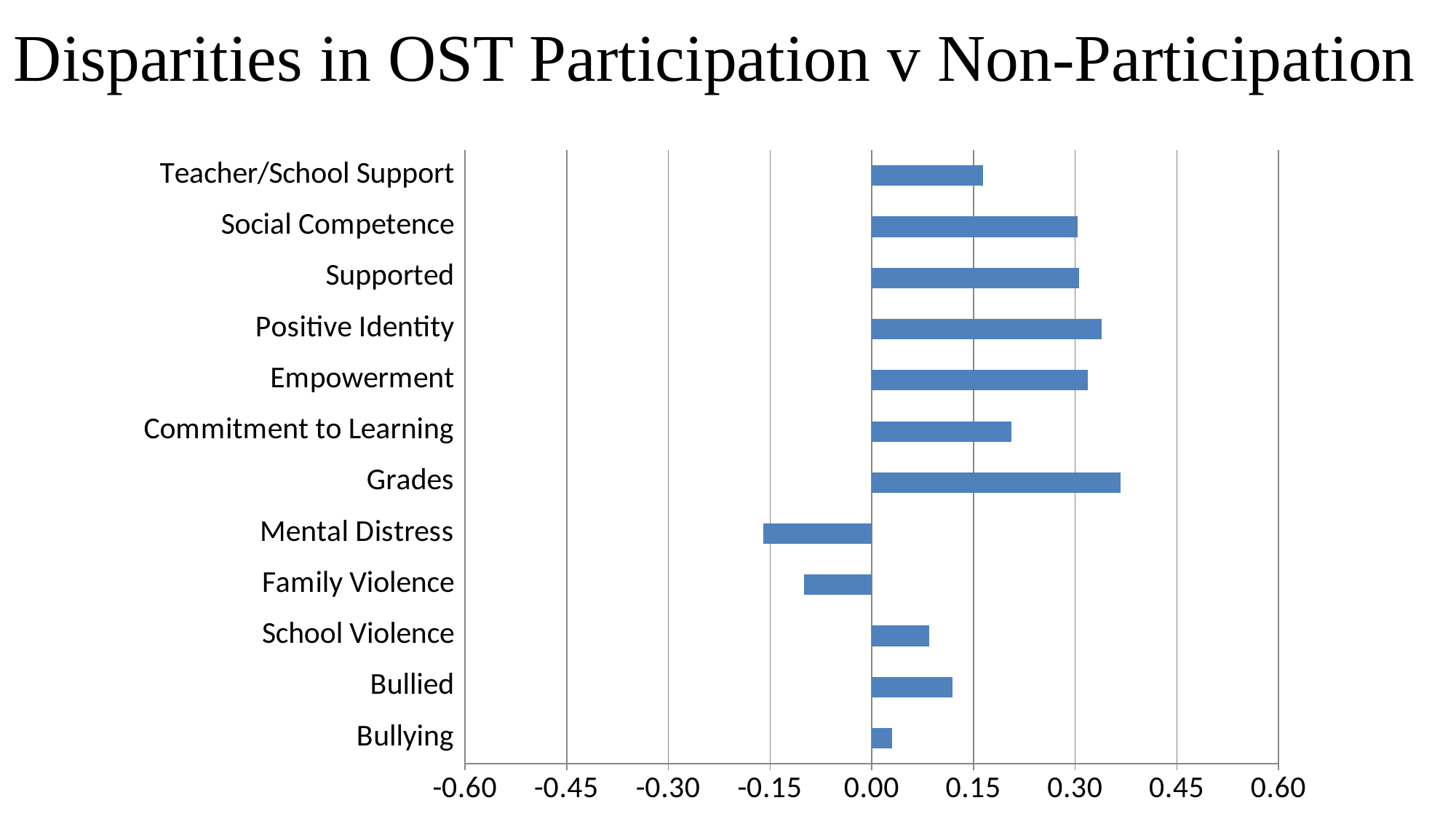
Which is larger, the value for Social Competence or the value for Commitment to Learning? Social Competence Is the value for Grades greater or less than 0.30? greater Is the value for Bullying greater or less than 0.15? less Which category has the lowest value? Mental Distress Is the value for Commitment to Learning greater or less than 0.15? greater What is the title of the chart? Disparities in OST Participation v Non-Participation How many categories are plotted on the chart? 12 Which category has the highest value? Grades How many categories have a negative value? 2 Which is larger, the value for Bullied or the value for Bullying? Bullied What kind of chart is shown on the slide? bar chart